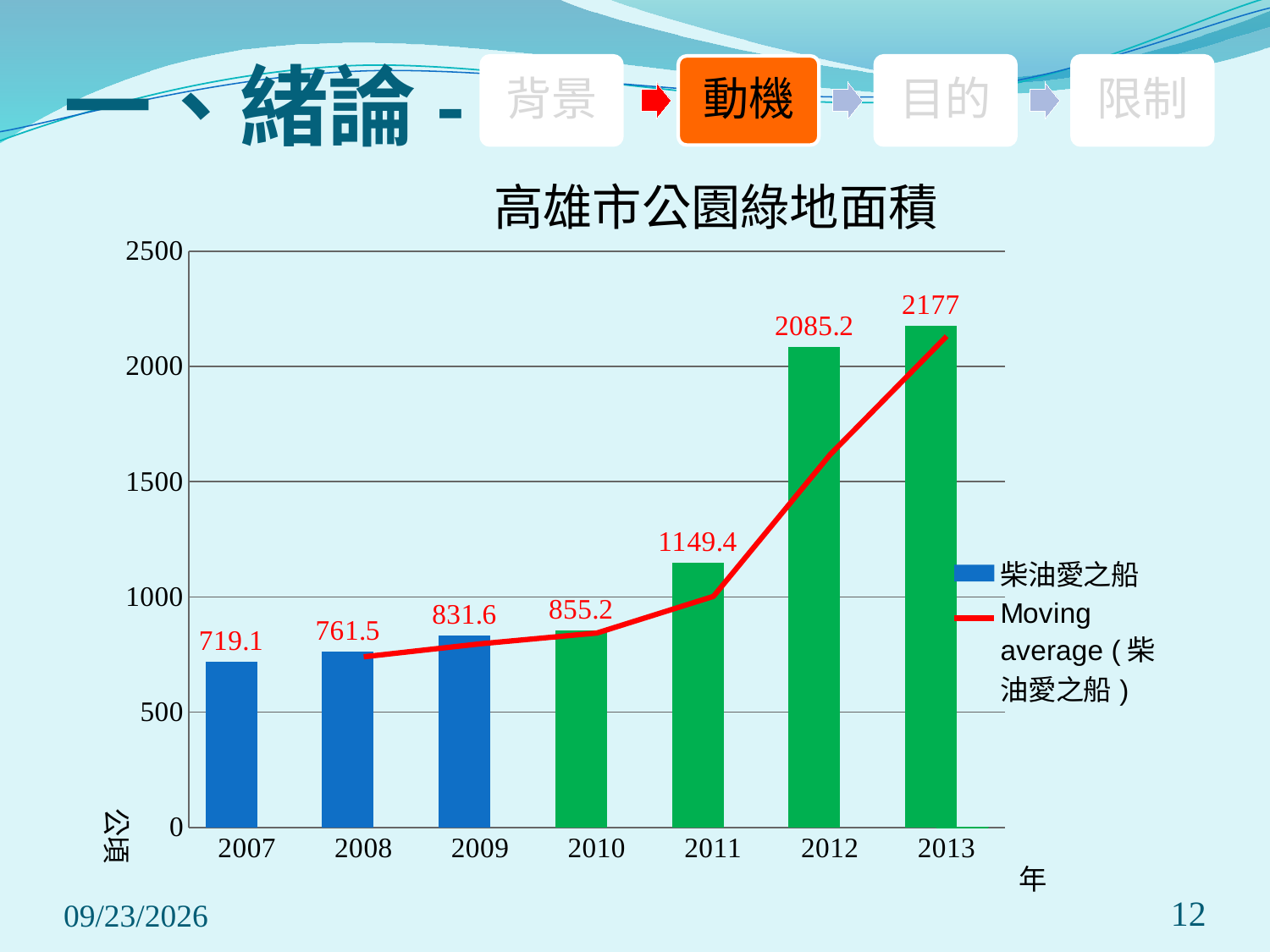
What is the difference between the values for 2010 and 2009? 23.6 What is the value for 2012 in the chart? 2085.2 What is the difference between the values for 2013 and 2012? 91.8 What is the value for 2007 in the chart? 719.1 What is the value for 2011 in the chart? 1149.4 How many series does the chart's legend list? 2 Which year has the highest value in the chart? 2013 Which year has the lowest value in the chart? 2007 How many years are shown on the x axis of the chart? 7 Which is larger, the value for 2011 or the value for 2010? 2011 Is the value for 2012 greater or less than 2000? greater What is the title of the chart? 高雄市公園綠地面積